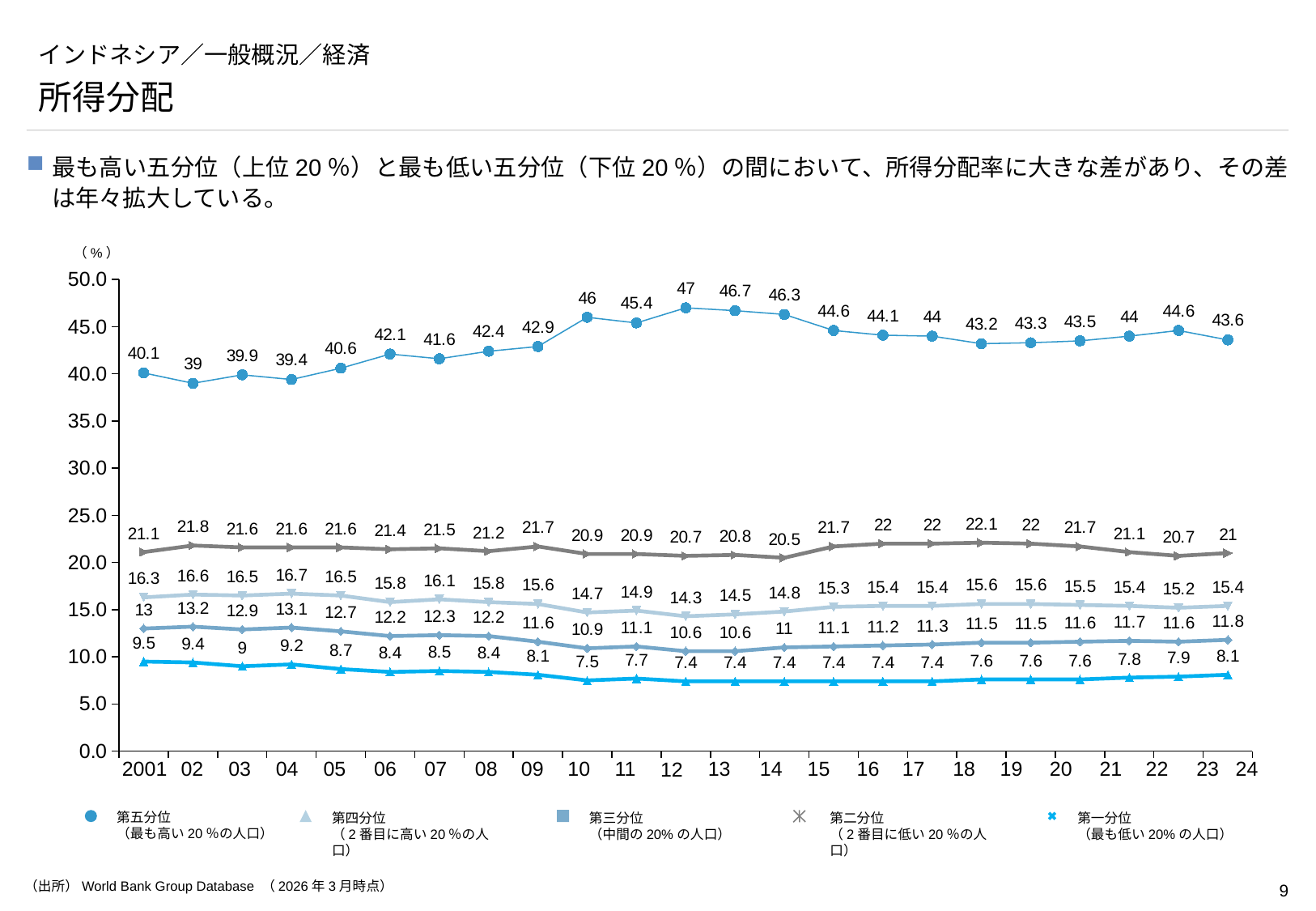
What is the value for 第二分位 in 2018? 22.1 How many series does the legend list? 5 What is the value for 第一分位 in 2001? 9.5 In which year is the value for 第五分位 lowest? 2002 What is the value for 第三分位 in 2013? 10.6 In which year is the value for 第五分位 highest? 2012 What kind of chart is shown on the slide? line chart What is the difference between 第五分位 and 第一分位 in 2001? 30.6 In 2004, which is larger, 第四分位 or 第三分位? 第四分位 What is the value for 第五分位 in 2012? 47 What unit is shown on the y axis of the chart? % Does the value for 第一分位 rise or fall from 2001 to 2010? fall